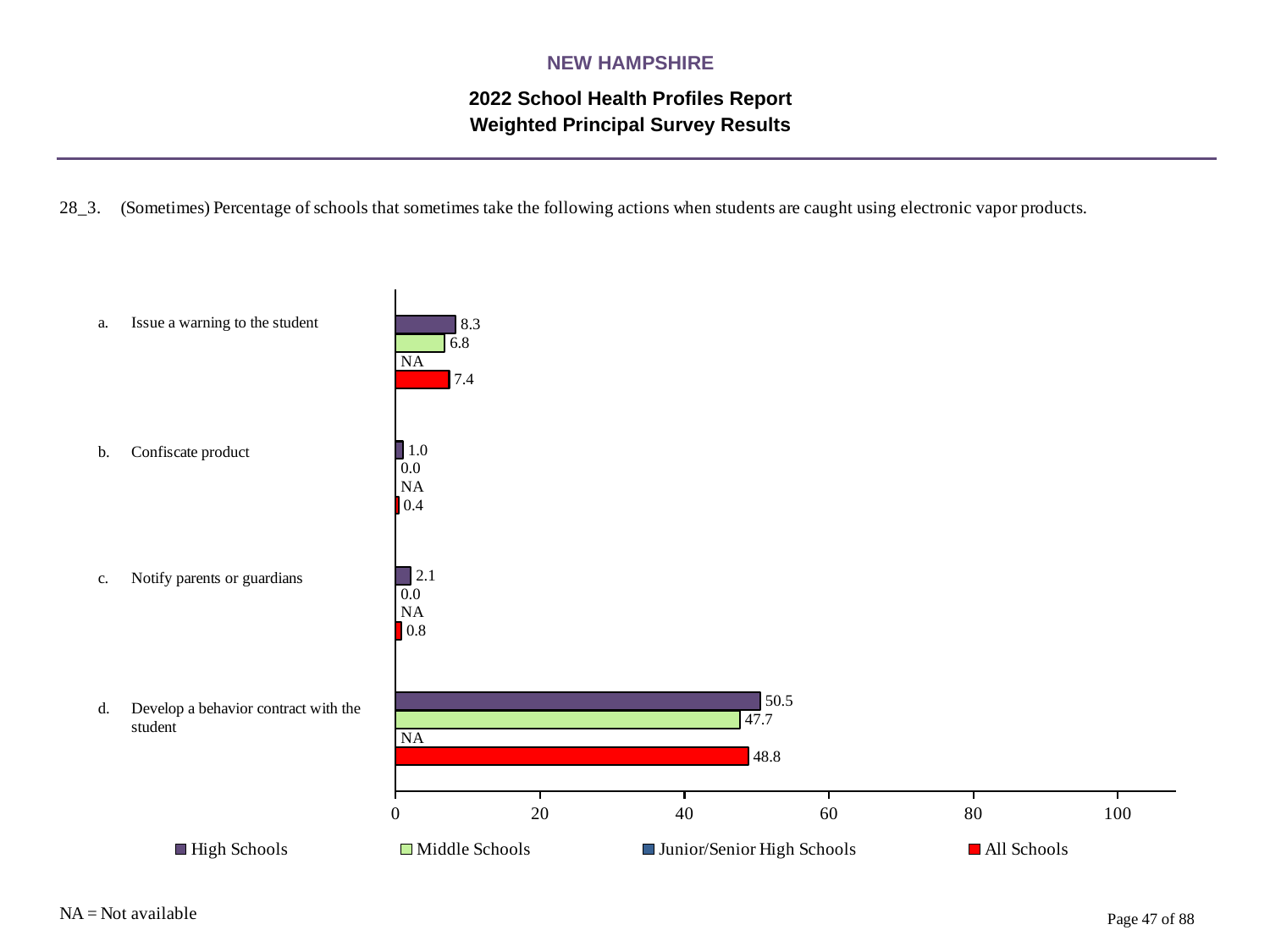
How many actions (categories) are shown in the chart? 4 Which action has the highest All Schools value? Develop a behavior contract with the student What is the High Schools value for 'Issue a warning to the student'? 8.3 How many series does the legend list? 4 What is the All Schools value for 'Develop a behavior contract with the student'? 48.8 What is the Middle Schools value for 'Confiscate product'? 0.0 What kind of chart is shown on the slide? Bar chart What is the difference between the High Schools and Middle Schools values for 'Develop a behavior contract with the student'? 2.8 For 'Issue a warning to the student', which is larger: the High Schools value or the Middle Schools value? High Schools What is the Junior/Senior High Schools value for 'Notify parents or guardians'? NA Is the High Schools value for 'Develop a behavior contract with the student' greater or less than 40? greater Which action has the lowest High Schools value? Confiscate product